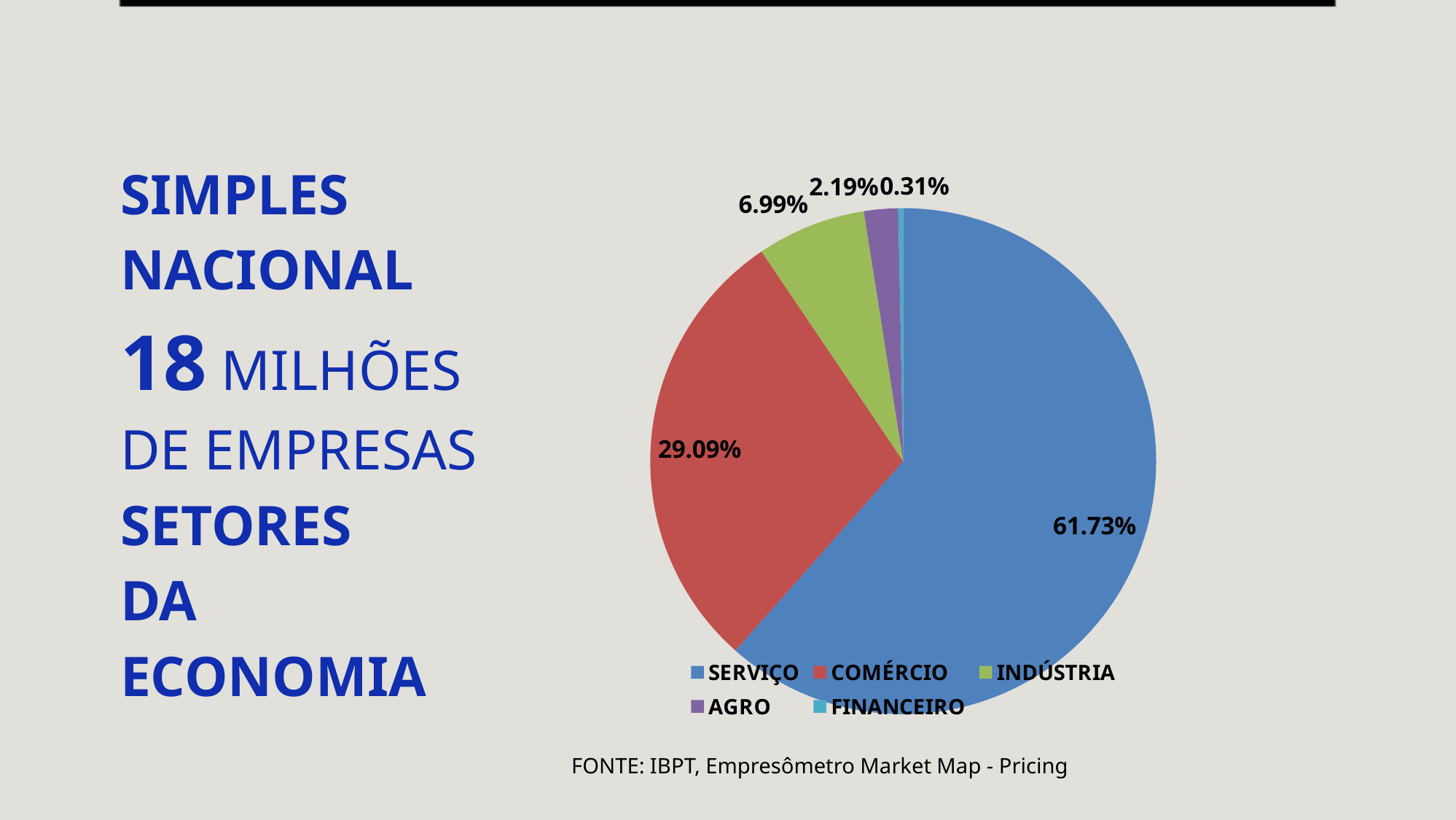
What share of the pie does INDÚSTRIA have? 6.99% What kind of chart is shown on the slide? pie chart Which sector has the largest slice of the pie? SERVIÇO What share of the pie does AGRO have? 2.19% How many sectors are shown in the pie chart? 5 Which sector has the smallest slice of the pie? FINANCEIRO What colour is the COMÉRCIO slice? red Which is larger, the INDÚSTRIA slice or the AGRO slice? INDÚSTRIA What share of the pie does COMÉRCIO have? 29.09% What is the difference between the SERVIÇO and COMÉRCIO shares? 32.64% What share of the pie does FINANCEIRO have? 0.31% What share of the pie does SERVIÇO have? 61.73%